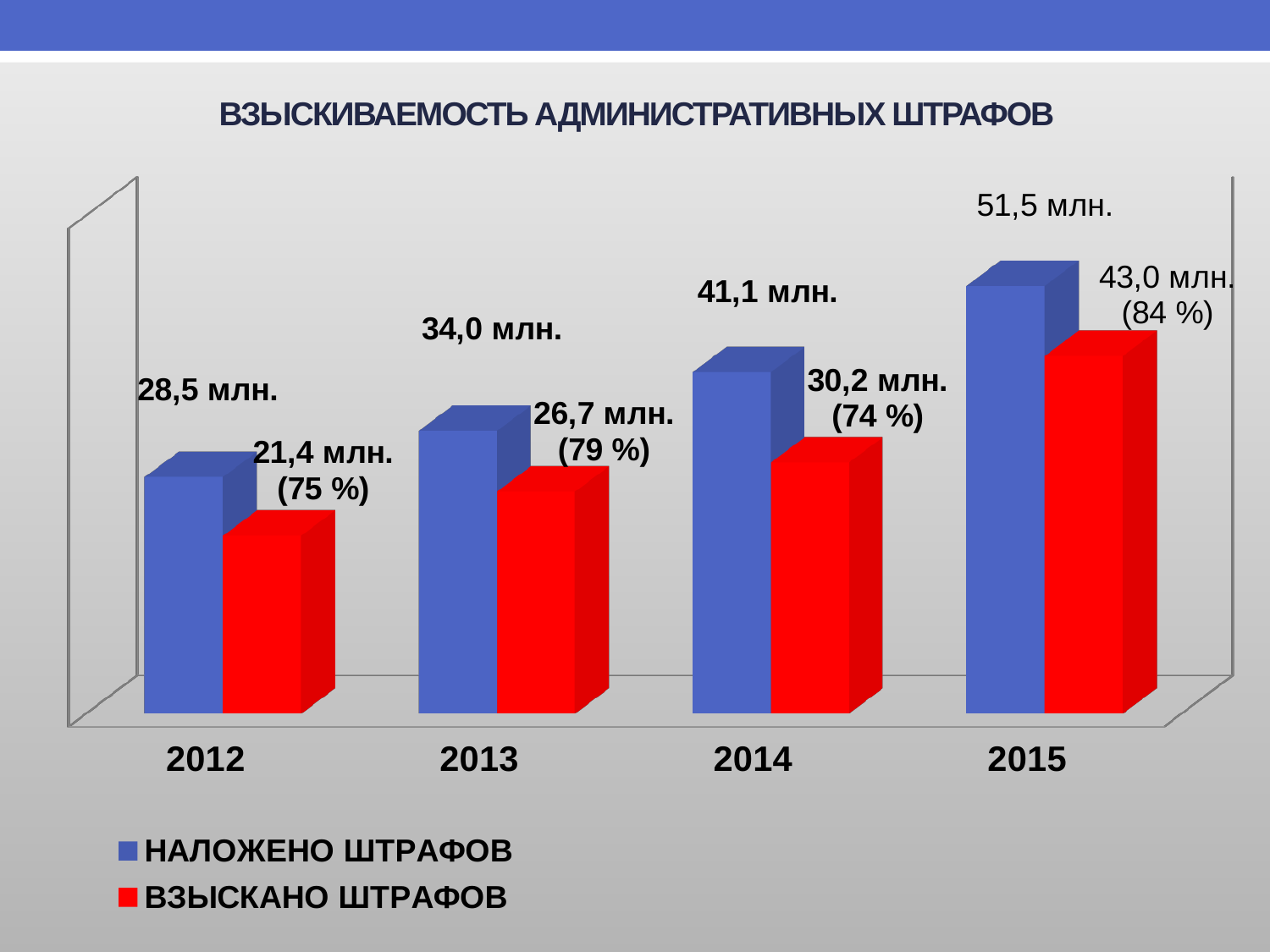
In which year is НАЛОЖЕНО ШТРАФОВ the highest? 2015 What is the value of НАЛОЖЕНО ШТРАФОВ for 2013? 34,0 млн. What percentage is shown next to the ВЗЫСКАНО ШТРАФОВ value for 2015? 84 % What type of chart is shown on the slide? Bar chart What is the value of ВЗЫСКАНО ШТРАФОВ for 2014? 30,2 млн. How many series does the legend list? 2 Do the НАЛОЖЕНО ШТРАФОВ values rise or fall from 2012 to 2015? Rise In which year is ВЗЫСКАНО ШТРАФОВ the lowest? 2012 What is the difference between НАЛОЖЕНО ШТРАФОВ and ВЗЫСКАНО ШТРАФОВ in 2015? 8,5 млн. Which is larger: ВЗЫСКАНО ШТРАФОВ in 2013 or ВЗЫСКАНО ШТРАФОВ in 2014? 2014 How many years are shown on the x axis? 4 What is the value of НАЛОЖЕНО ШТРАФОВ for 2012? 28,5 млн.